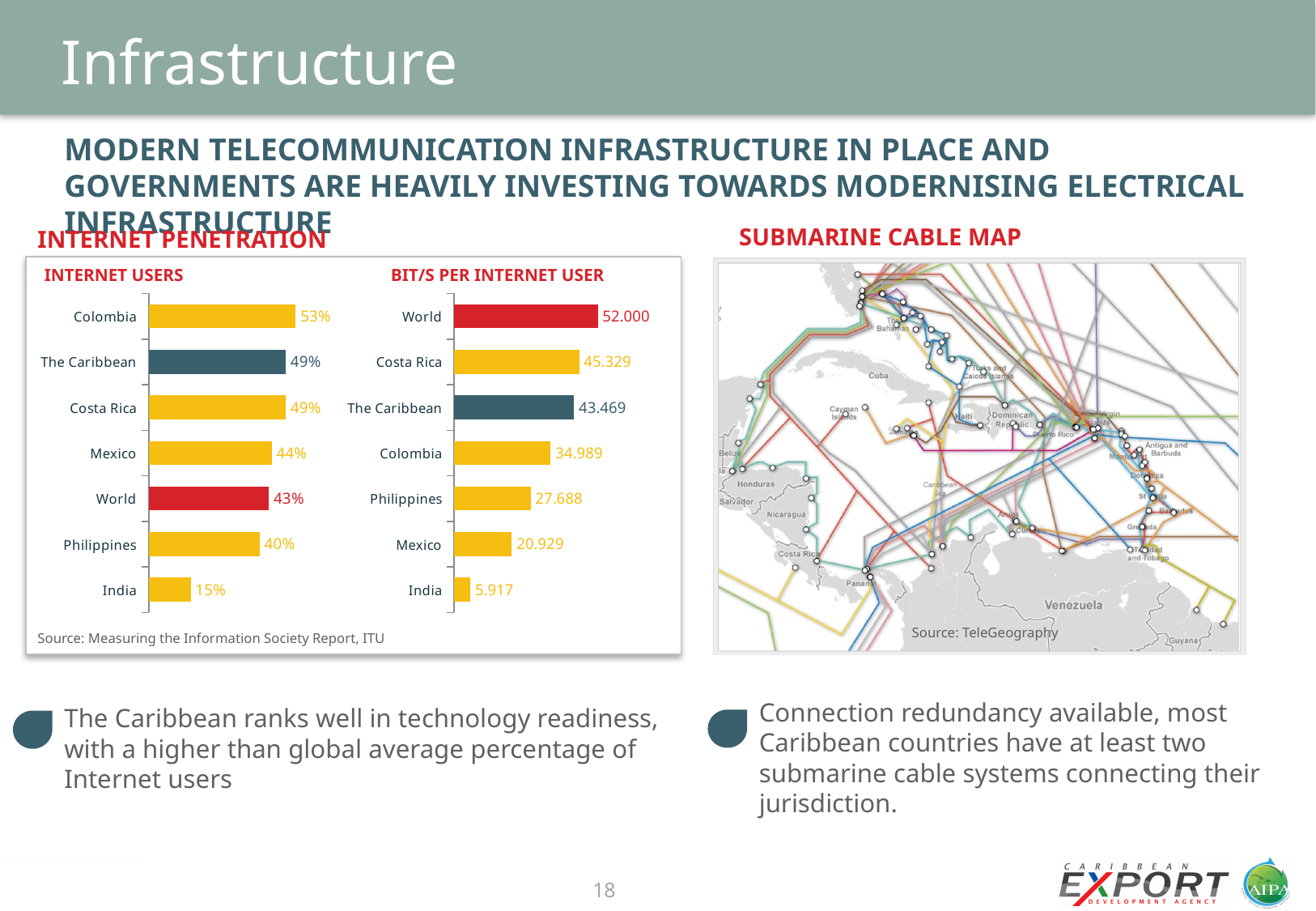
In the Internet Users chart, what is the value for India? 15% In the Bit/s per Internet User chart, what is the difference between World and The Caribbean? 8.531 In the Internet Users chart, what is the difference between Colombia and India? 38 percentage points In the Bit/s per Internet User chart, what is the value for Mexico? 20.929 In the Internet Users chart, which is larger, The Caribbean or World? The Caribbean In the Internet Users chart, which category has the highest value? Colombia In the Bit/s per Internet User chart, which category has the lowest value? India How many categories are shown in the Bit/s per Internet User chart? 7 In the Bit/s per Internet User chart, which category has the highest value? World In the Internet Users chart, what is the value for The Caribbean? 49% In the Bit/s per Internet User chart, what is the value for Costa Rica? 45.329 What kind of chart is the Internet Users chart? Bar chart